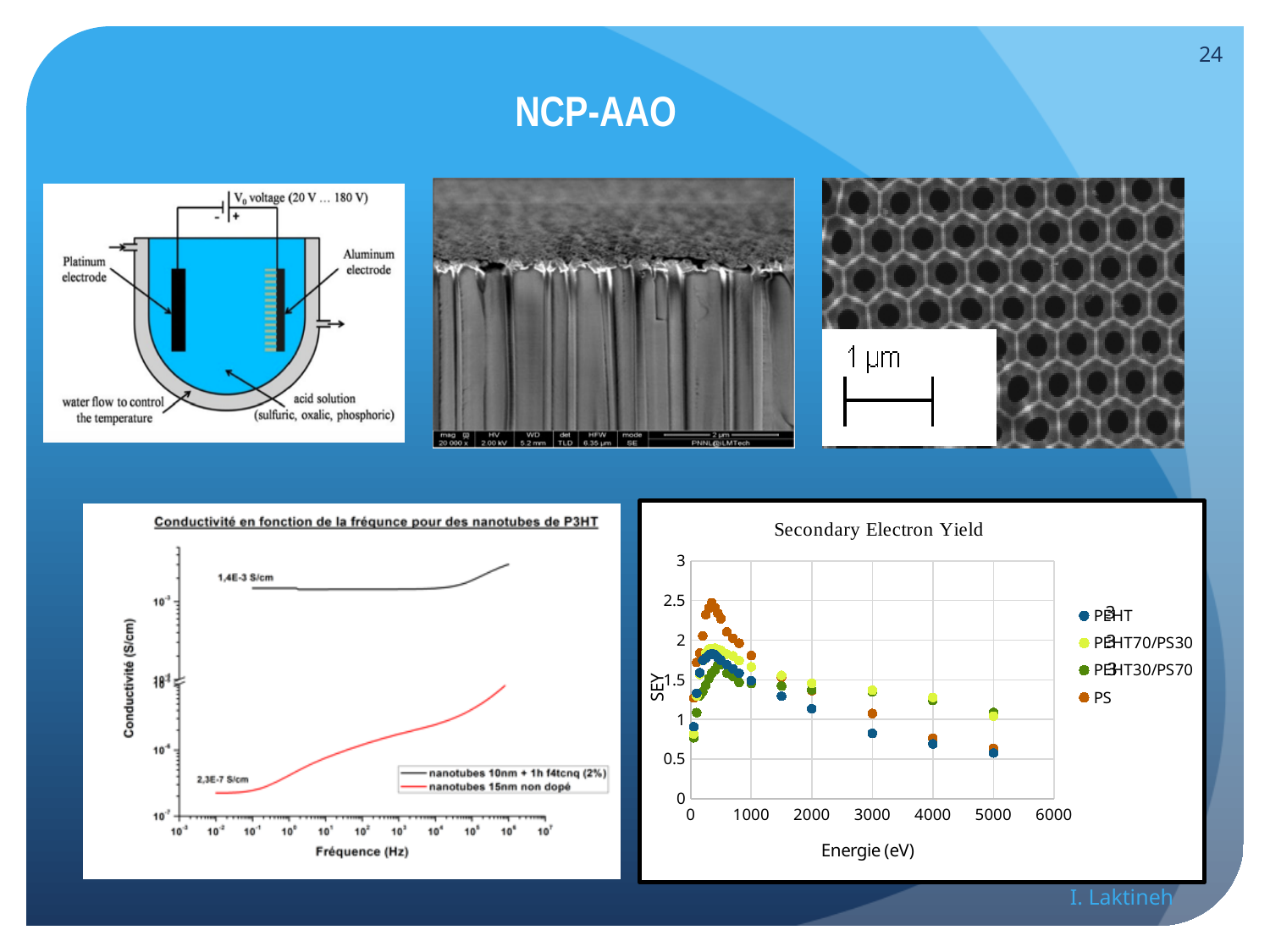
In the Secondary Electron Yield chart, is the SEY value for P3HT at 5000 eV greater or less than 1? less In the conductivity chart on the left, which series has the higher conductivity: nanotubes 10nm + 1h f4tcnq (2%) or nanotubes 15nm non dopé? nanotubes 10nm + 1h f4tcnq (2%) In the conductivity chart on the left, how many series does the legend list? 2 In the Secondary Electron Yield chart, which series has the lowest SEY values at low energy (below 500 eV)? P3HT30/PS70 In the Secondary Electron Yield chart, do the SEY values rise or fall as energy increases from 1000 eV to 5000 eV? fall In the Secondary Electron Yield chart, how many series does the legend list? 4 In the conductivity chart on the left, what conductivity value is labelled on the red curve for nanotubes 15nm non dopé? 2,3E-7 S/cm In the conductivity chart on the left, what conductivity value is labelled on the black curve for nanotubes 10nm + 1h f4tcnq (2%)? 1,4E-3 S/cm In the Secondary Electron Yield chart, which series reaches the highest SEY value? PS In the Secondary Electron Yield chart, is the peak SEY value for PS greater or less than 2? greater In the Secondary Electron Yield chart, what is the maximum value shown on the SEY axis? 3 In the Secondary Electron Yield chart, what is the label of the x axis? Energie (eV)